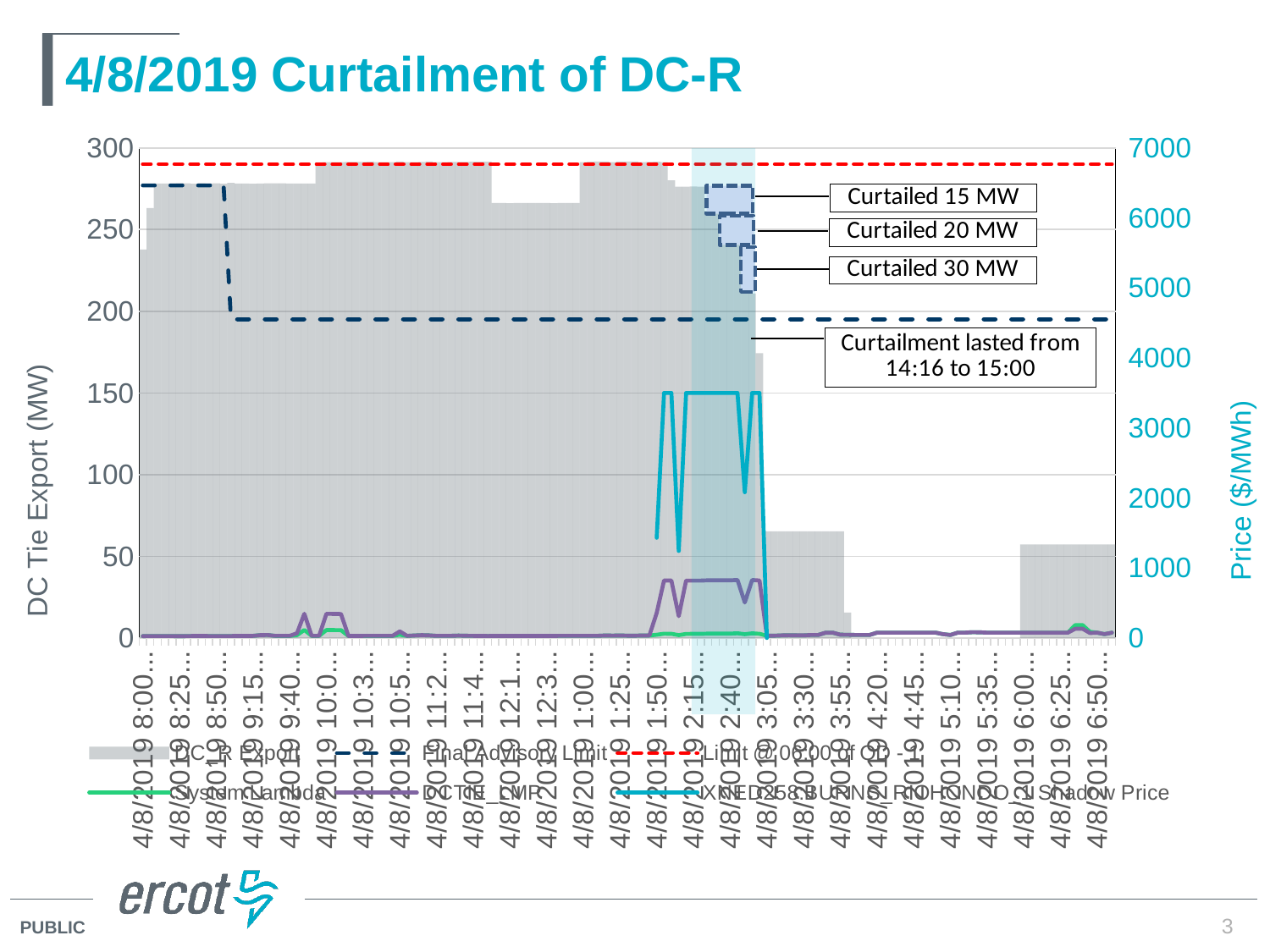
What is the title of the chart on the slide? 4/8/2019 Curtailment of DC-R Is the Final Advisory Limit after 9:15 greater or less than 200 MW? less What is the label of the left vertical axis? DC Tie Export (MW) What is the smallest curtailment amount labelled on the chart? Curtailed 15 MW What is the maximum value shown on the right-hand Price axis? 7000 Which is larger, the Curtailed 20 MW amount or the Curtailed 30 MW amount? Curtailed 30 MW Is the peak of the Shadow Price line greater or less than 3000 $/MWh? greater Is the Final Advisory Limit at 8:00 greater or less than 250 MW? greater According to the annotation, when did the curtailment last from and to? 14:16 to 15:00 How many curtailment amount annotations are shown on the chart? 3 What is the difference between the largest and smallest labelled curtailment amounts? 15 MW What is the largest curtailment amount labelled on the chart? Curtailed 30 MW